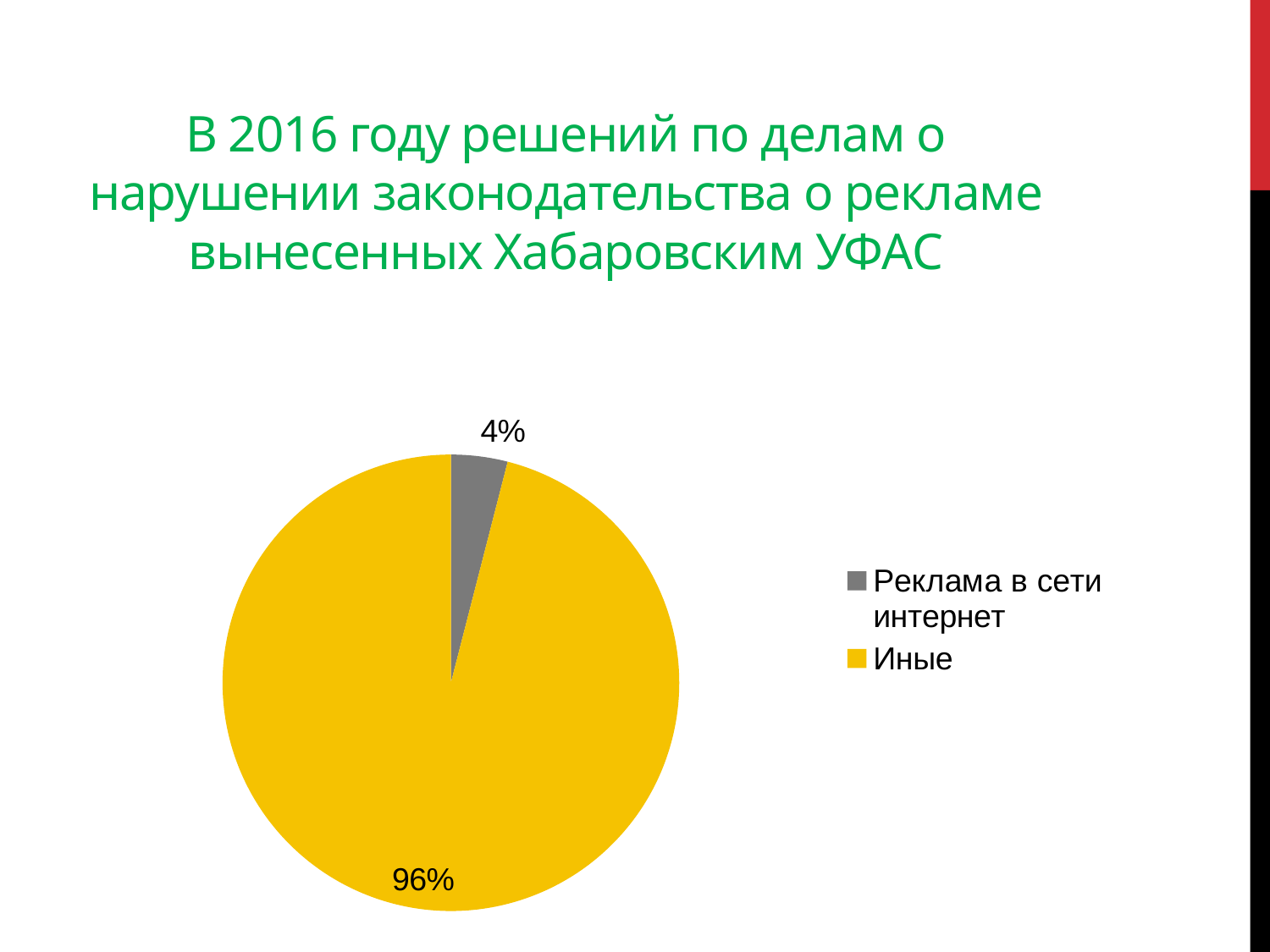
Which is larger: the slice for "Иные" or the slice for "Реклама в сети интернет"? Иные How many slices does the pie chart have? 2 What is the difference in percentage points between the "Иные" slice and the "Реклама в сети интернет" slice? 92 What share of the pie does "Иные" take? 96% What colour is the slice for "Реклама в сети интернет"? grey What share of the pie does "Реклама в сети интернет" take? 4% What kind of chart is shown on the slide? pie chart What colour is the slice for "Иные"? yellow Which category has the smallest slice of the pie? Реклама в сети интернет Which category has the largest slice of the pie? Иные How many entries does the legend list? 2